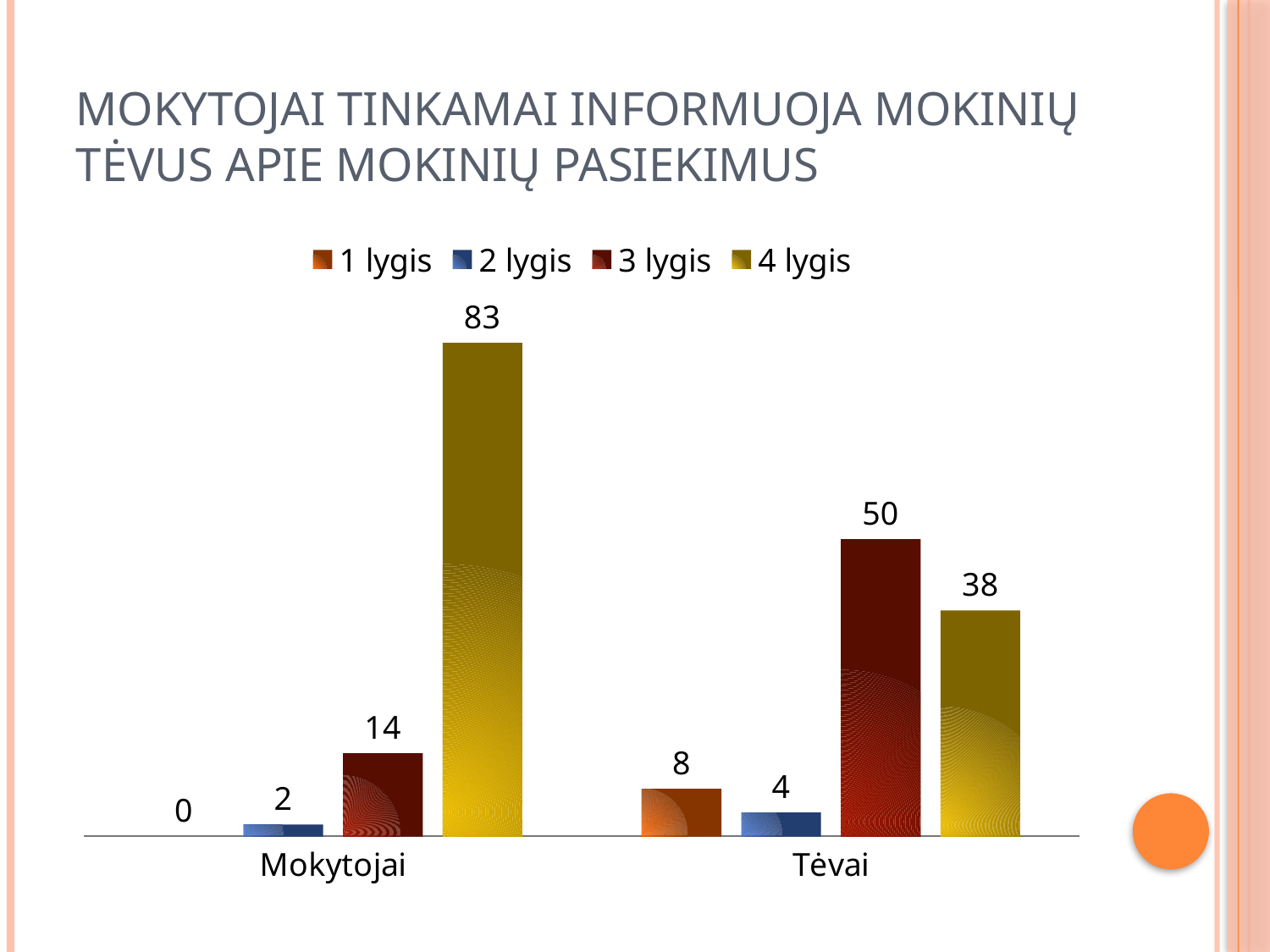
What is the value for 1 lygis in the Mokytojai category? 0 How many series does the legend list? 4 Which is larger: the 3 lygis value for Mokytojai or the 3 lygis value for Tėvai? Tėvai What is the difference between the 4 lygis values for Mokytojai and Tėvai? 45 How many categories are shown on the x axis? 2 What is the difference between the 1 lygis and 2 lygis values in the Tėvai category? 4 Which series has the highest value in the Tėvai category? 3 lygis What is the value for 2 lygis in the Tėvai category? 4 What is the value for 3 lygis in the Tėvai category? 50 Which series has the lowest value in the Mokytojai category? 1 lygis What kind of chart is shown on the slide? Bar chart What is the value for 4 lygis in the Mokytojai category? 83